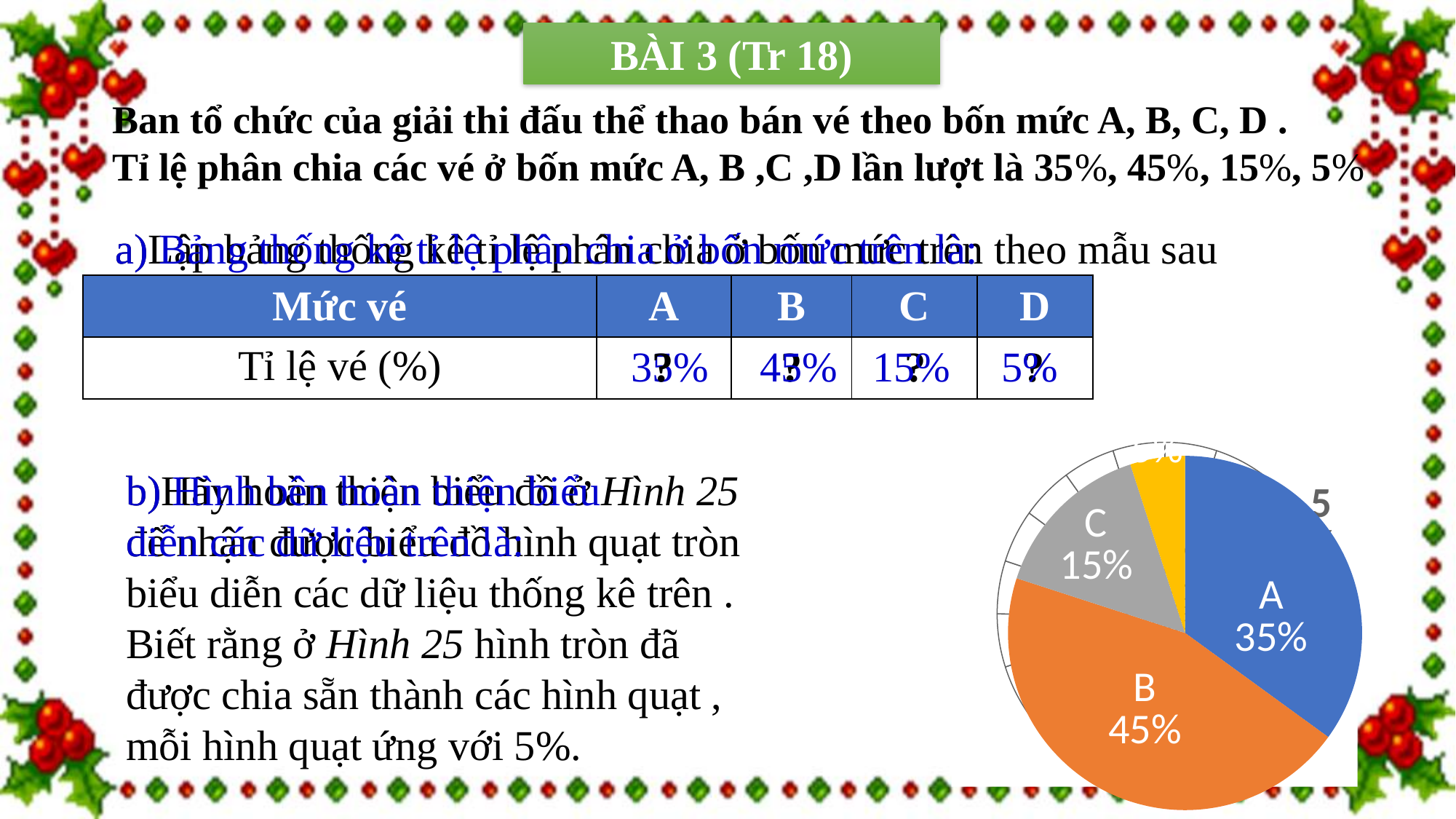
How many slices does the pie chart have? 4 In the pie chart, what percentage is shown for slice B? 45% In the pie chart, what percentage is shown for slice A? 35% In the pie chart, what percentage is shown for slice C? 15% Which labelled slice of the pie chart is the largest? B Which is larger in the pie chart, slice A or slice C? A What colour is slice A in the pie chart? blue What colour is slice B in the pie chart? orange What kind of chart is shown on the slide? pie chart What is the difference between the percentages of slices B and A in the pie chart? 10% Which slice of the pie chart is the smallest? the yellow slice (D) What is the combined percentage of slices A and B in the pie chart? 80%